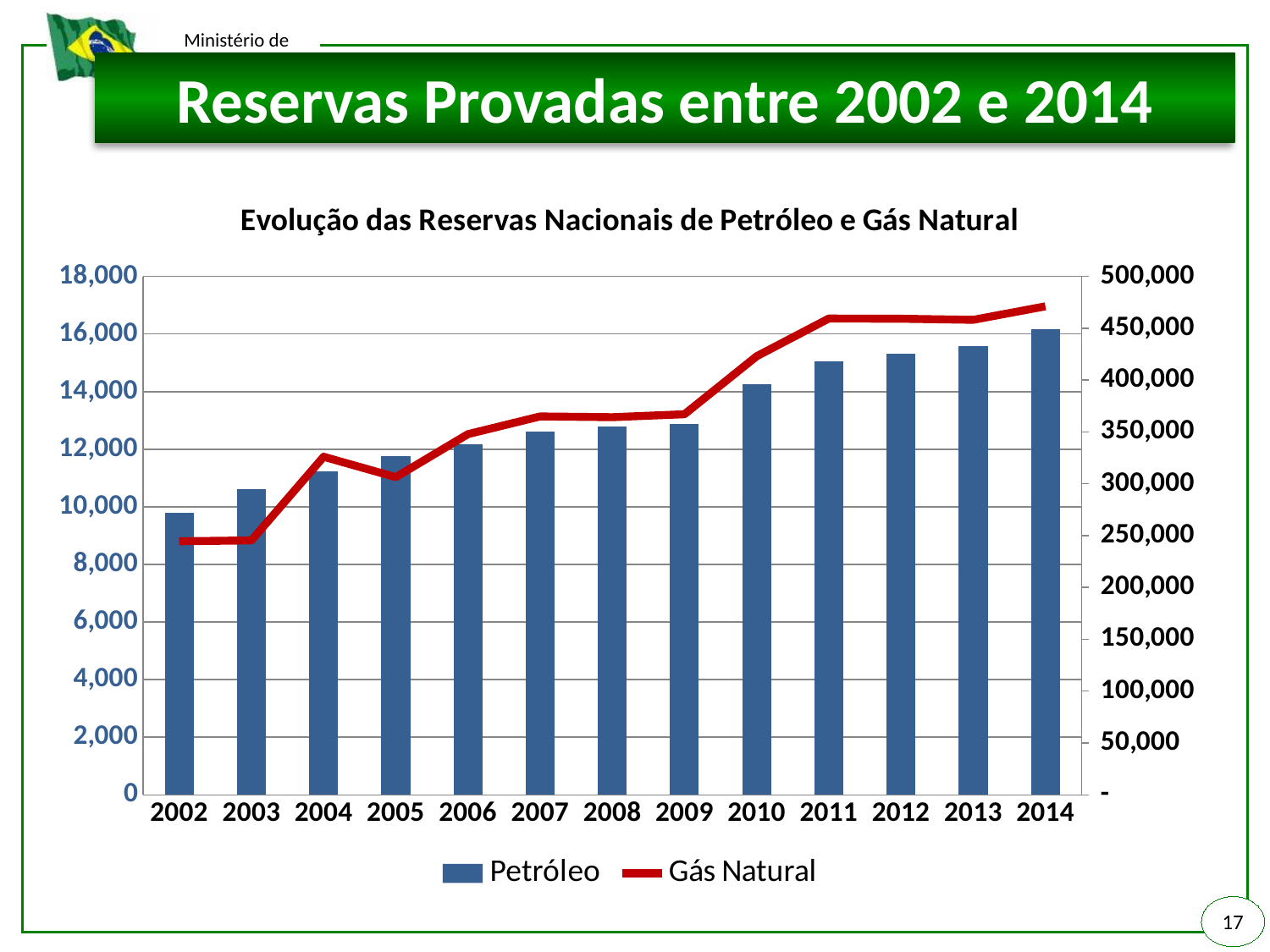
How many years are shown on the x axis? 13 Do the Petróleo values generally rise or fall from 2002 to 2014? rise Which year has the lowest Petróleo bar? 2002 Is the Petróleo value for 2007 greater or less than 12,000? greater Which year has the larger Petróleo bar, 2004 or 2005? 2005 Which year has the highest Petróleo bar? 2014 Is the Gás Natural value for 2009 greater or less than 350,000? greater What type of chart is shown on the slide? Combined bar and line chart Is the Petróleo value for 2013 greater or less than 16,000? less Which year has the highest Gás Natural value? 2014 How many series does the legend list? 2 What is the title of the chart? Evolução das Reservas Nacionais de Petróleo e Gás Natural